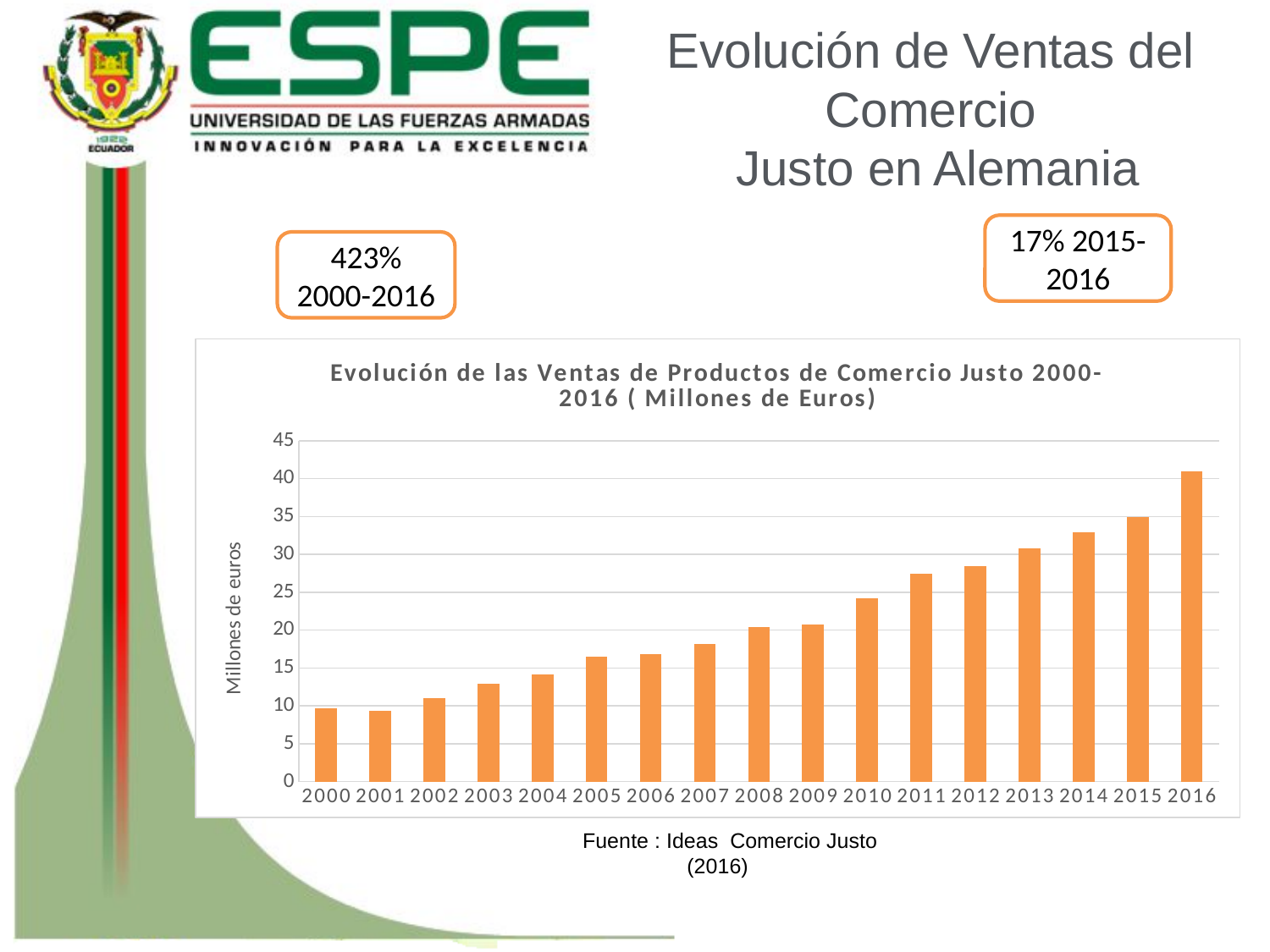
Which year has the highest sales value in the chart? 2016 Is the value for 2013 greater or less than 30? greater What is the title of the chart? Evolución de las Ventas de Productos de Comercio Justo 2000-2016 ( Millones de Euros) Is the value for 2004 greater or less than 15? less Which is larger, the value for 2010 or the value for 2005? 2010 Do the values generally rise or fall from 2000 to 2016? rise What kind of chart is shown on the slide? bar chart Is the value for 2016 greater or less than 40? greater How many years are plotted on the x axis of the chart? 17 What is the label on the vertical axis of the chart? Millones de euros